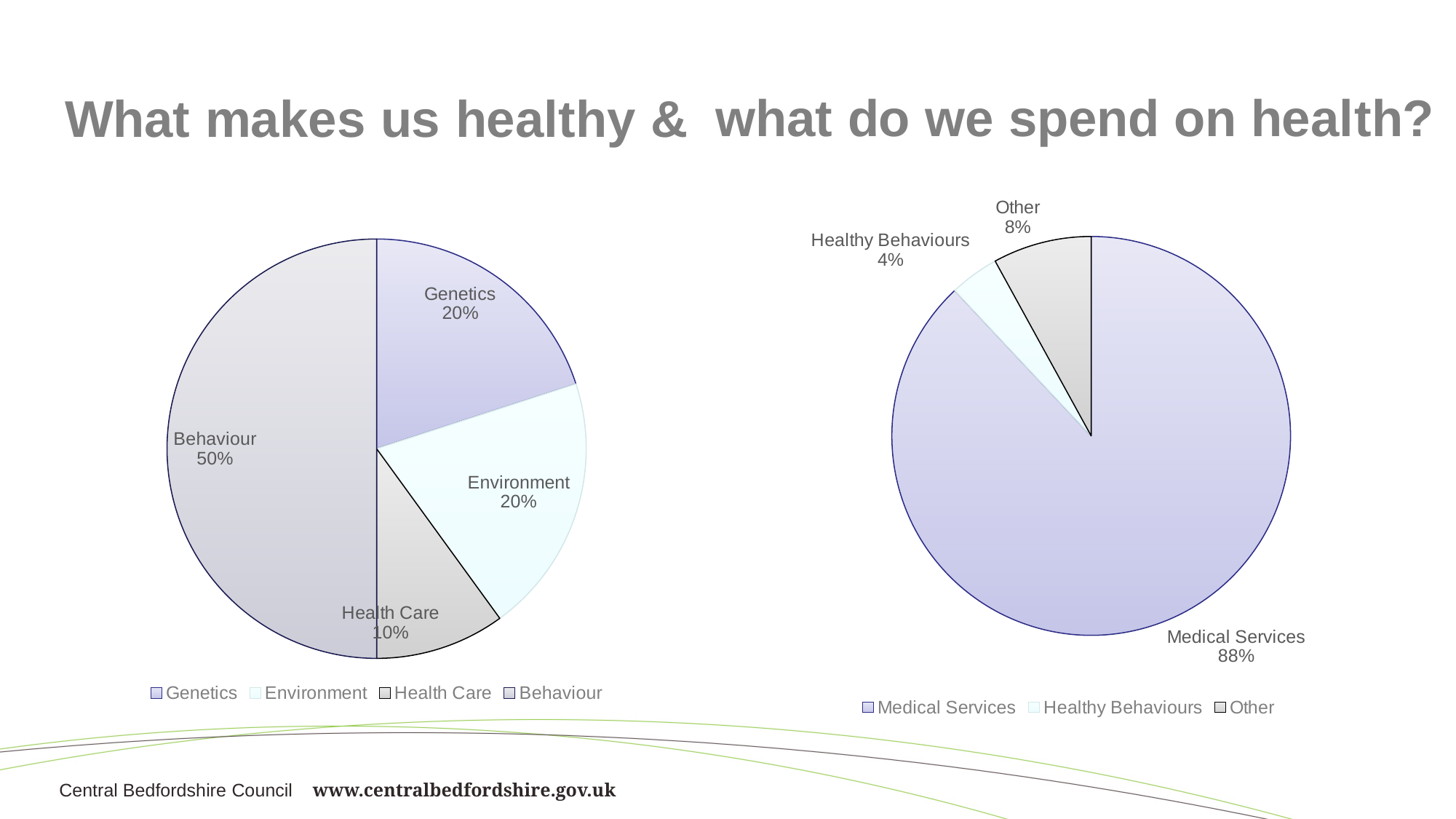
What type of chart is shown on the right of the slide? Pie chart How many entries does the legend of the right pie chart list? 3 In the left pie chart, what share does Health Care have? 10% In the left pie chart, which category has the smallest slice? Health Care In the left pie chart, which category has the largest slice? Behaviour In the right pie chart, what share does Healthy Behaviours have? 4% In the right pie chart, what share does Medical Services have? 88% In the right pie chart, which category has the smallest slice? Healthy Behaviours In the left pie chart, which is larger, Genetics or Health Care? Genetics In the left pie chart, what share does Behaviour have? 50% How many slices does the left pie chart have? 4 In the right pie chart, what is the difference between Medical Services and Other? 80%